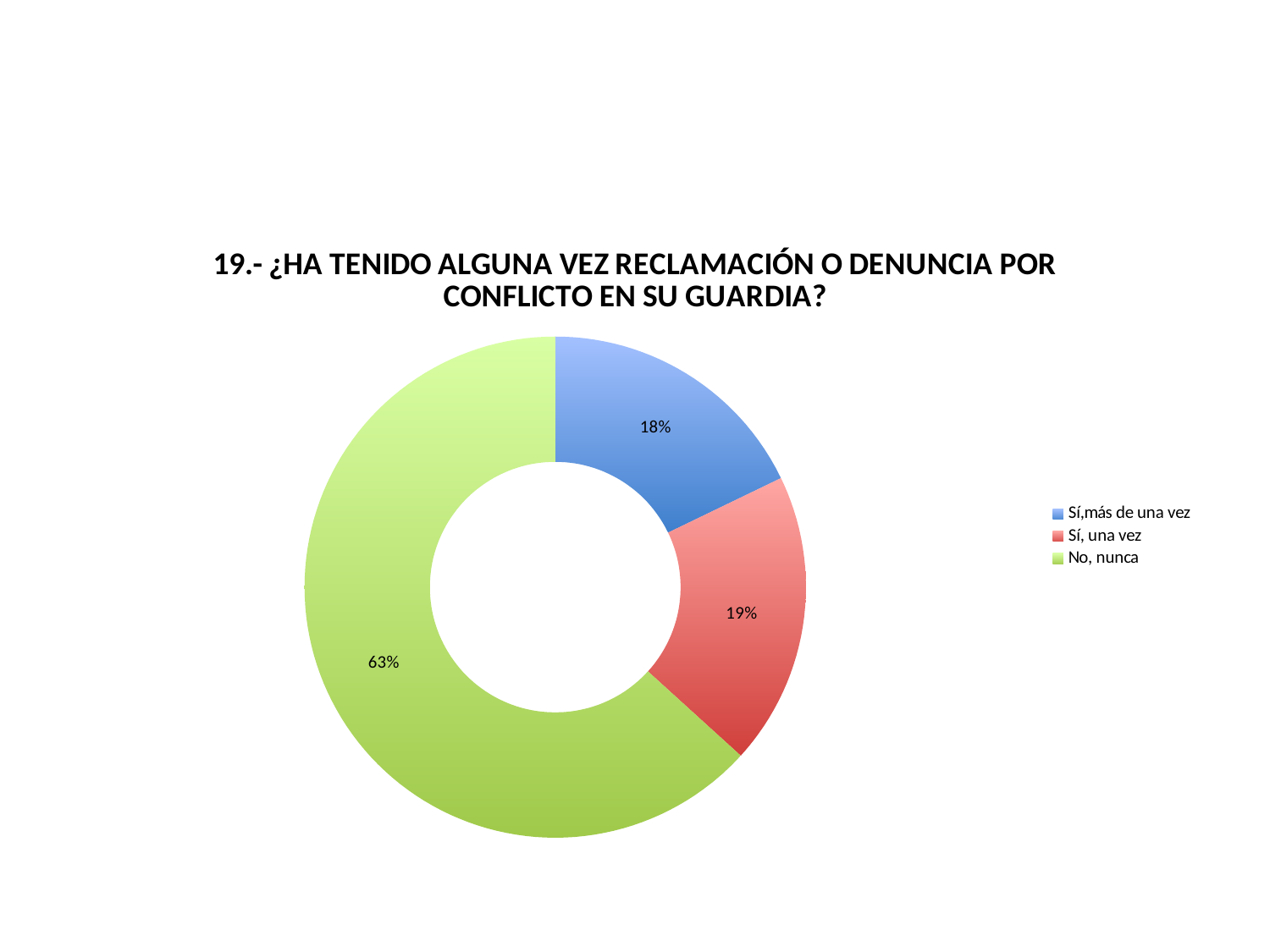
What is the difference in percentage points between "Sí, una vez" and "Sí,más de una vez"? 1 How many categories does the chart show? 3 What kind of chart is shown on the slide? Doughnut chart What colour represents "No, nunca" in the chart? Green Which category has the largest share of the chart? No, nunca What percentage of respondents answered "Sí, una vez"? 19% What is the difference in percentage points between "No, nunca" and "Sí, una vez"? 44 Which category has the smallest share of the chart? Sí,más de una vez What percentage of respondents answered "No, nunca"? 63% What is the title of the chart? 19.- ¿HA TENIDO ALGUNA VEZ RECLAMACIÓN O DENUNCIA POR CONFLICTO EN SU GUARDIA? Which is larger: the share for "No, nunca" or the share for "Sí, una vez"? No, nunca What percentage of respondents answered "Sí,más de una vez"? 18%